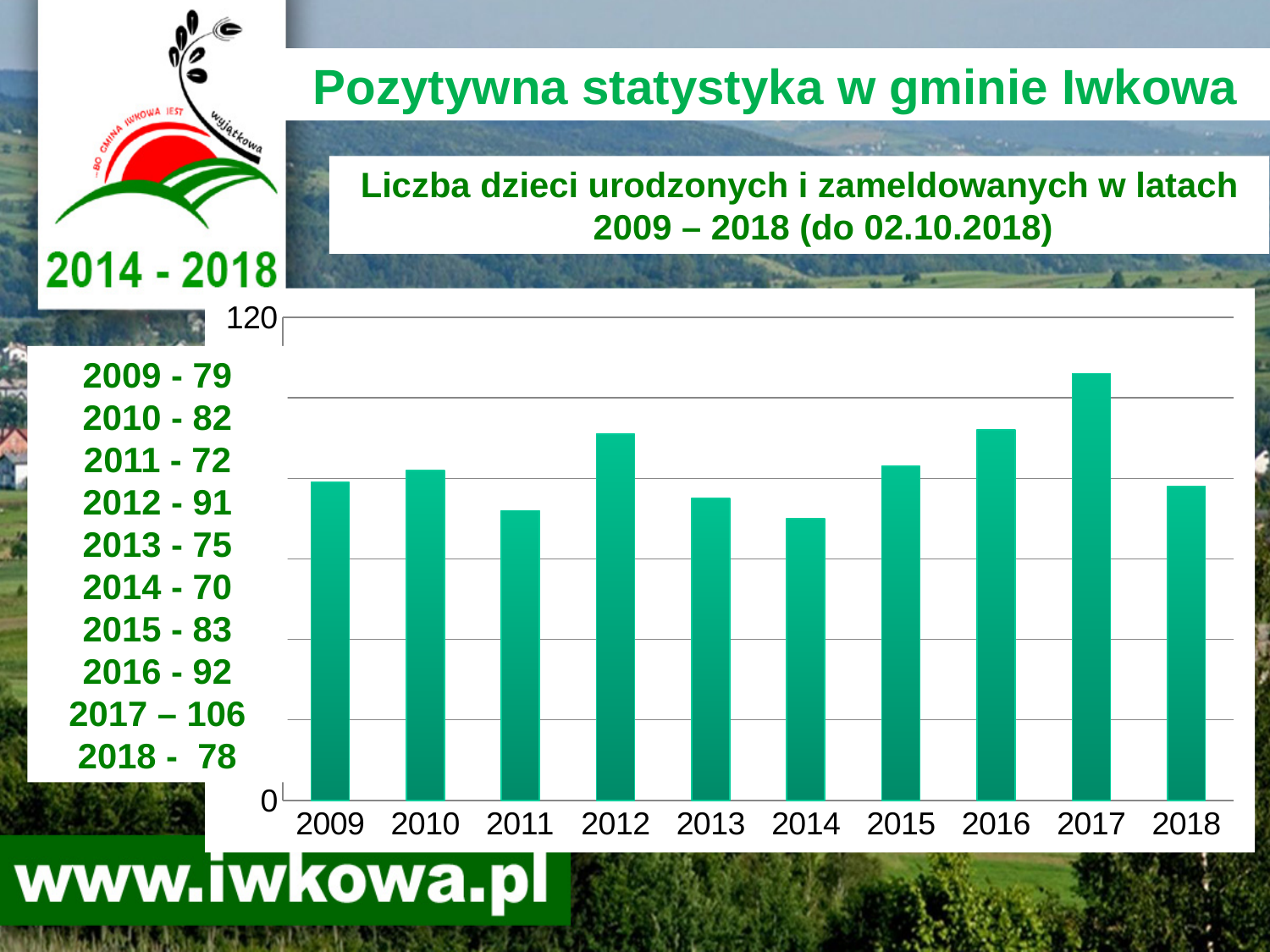
Which is larger, the value for 2016 or the value for 2015? 2016 Which year has the lowest number of children born and registered? 2014 What is the value for 2012? 91 Is the value for 2017 greater or less than 100? greater What is the difference between the values for 2017 and 2014? 36 What is the value for 2018? 78 Do the values rise or fall from 2013 to 2014? fall Which year has the highest number of children born and registered? 2017 What type of chart is shown on the slide? bar chart What is the value for 2017? 106 How many years are plotted on the chart? 10 What is the maximum value shown on the vertical axis? 120